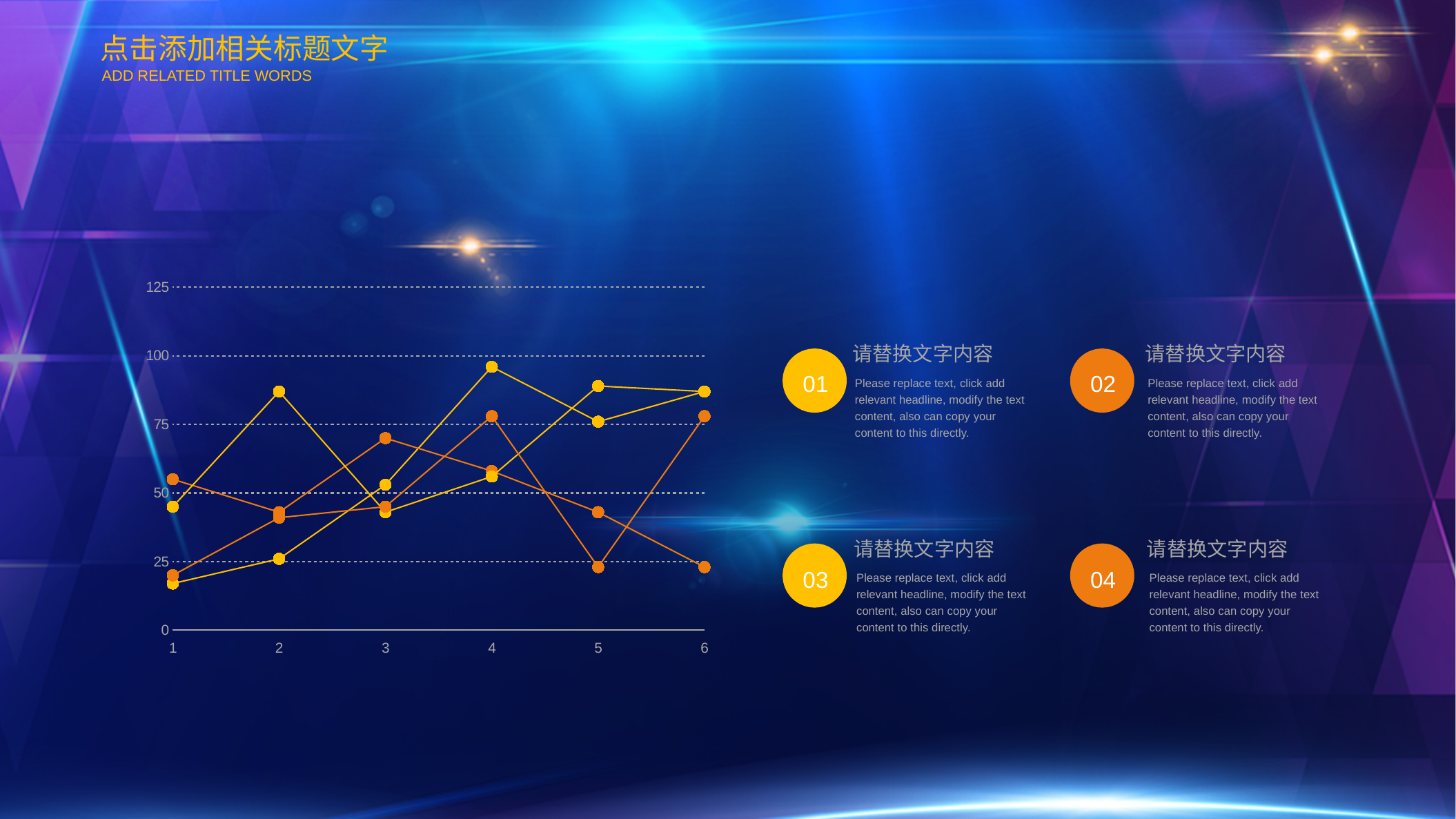
Is the highest point on the chart greater or less than 100? less At which x-axis category does the highest point on the chart occur? 4 What is the highest value labelled on the y axis of the chart? 125 Does the chart display a legend? No Is the lowest point on the chart greater or less than 25? less How many lines are plotted on the chart? 4 What kind of chart is shown on the slide? line chart How many categories are shown on the x axis of the chart? 6 At which x-axis category does the lowest point on the chart occur? 1